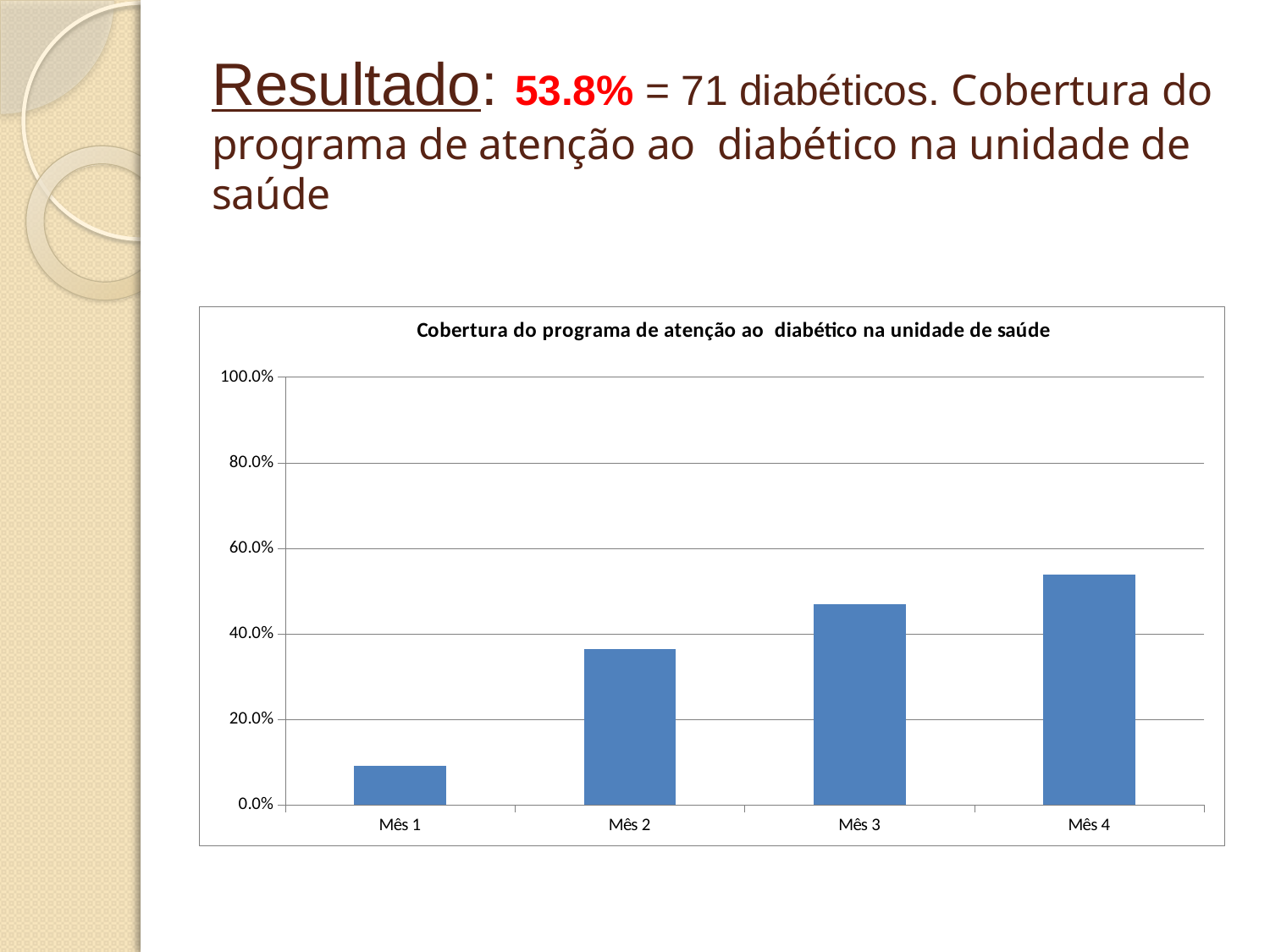
Is the value for Mês 2 greater or less than 40.0%? less Which month has the highest coverage value? Mês 4 How many months (categories) are plotted on the chart? 4 Is the value for Mês 4 greater or less than 60.0%? less Which is larger, the value for Mês 2 or the value for Mês 3? Mês 3 Do the values rise or fall from Mês 1 to Mês 4? rise What is the highest value shown on the vertical axis of the chart? 100.0% Which month has the lowest coverage value? Mês 1 Is the value for Mês 1 greater or less than 20.0%? less What kind of chart is shown on the slide? bar chart What is the title of the chart? Cobertura do programa de atenção ao diabético na unidade de saúde